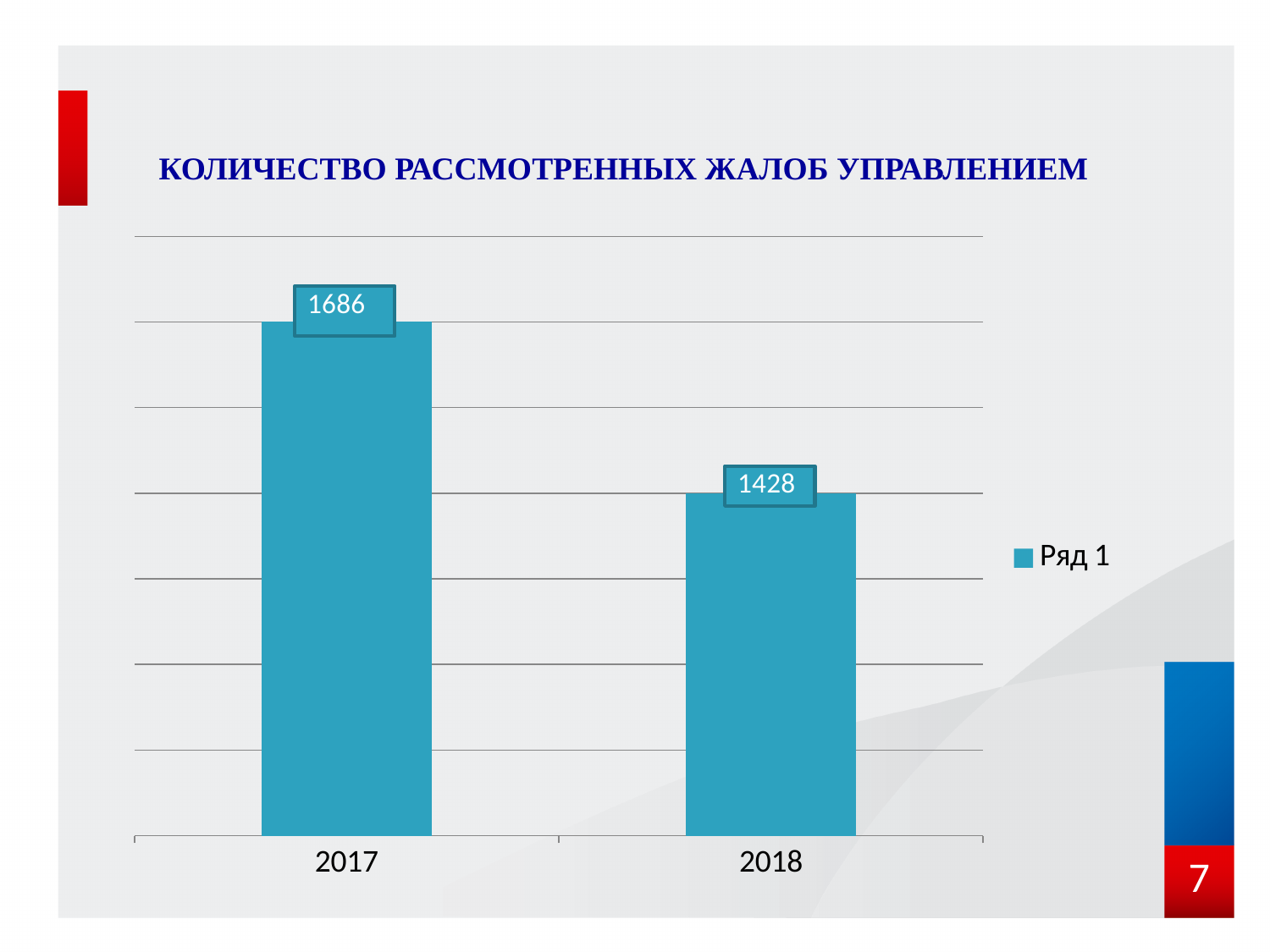
What is the name of the series listed in the legend? Ряд 1 Which is larger, the value for 2017 or the value for 2018? 2017 What is the value for 2017? 1686 What is the value for 2018? 1428 Do the values rise or fall from 2017 to 2018? fall What is the difference between the values for 2017 and 2018? 258 What is the title of the chart? КОЛИЧЕСТВО РАССМОТРЕННЫХ ЖАЛОБ УПРАВЛЕНИЕМ How many series does the legend list? 1 Which year has the highest value? 2017 How many categories are shown on the x axis? 2 What kind of chart is shown on the slide? bar chart Which year has the lowest value? 2018